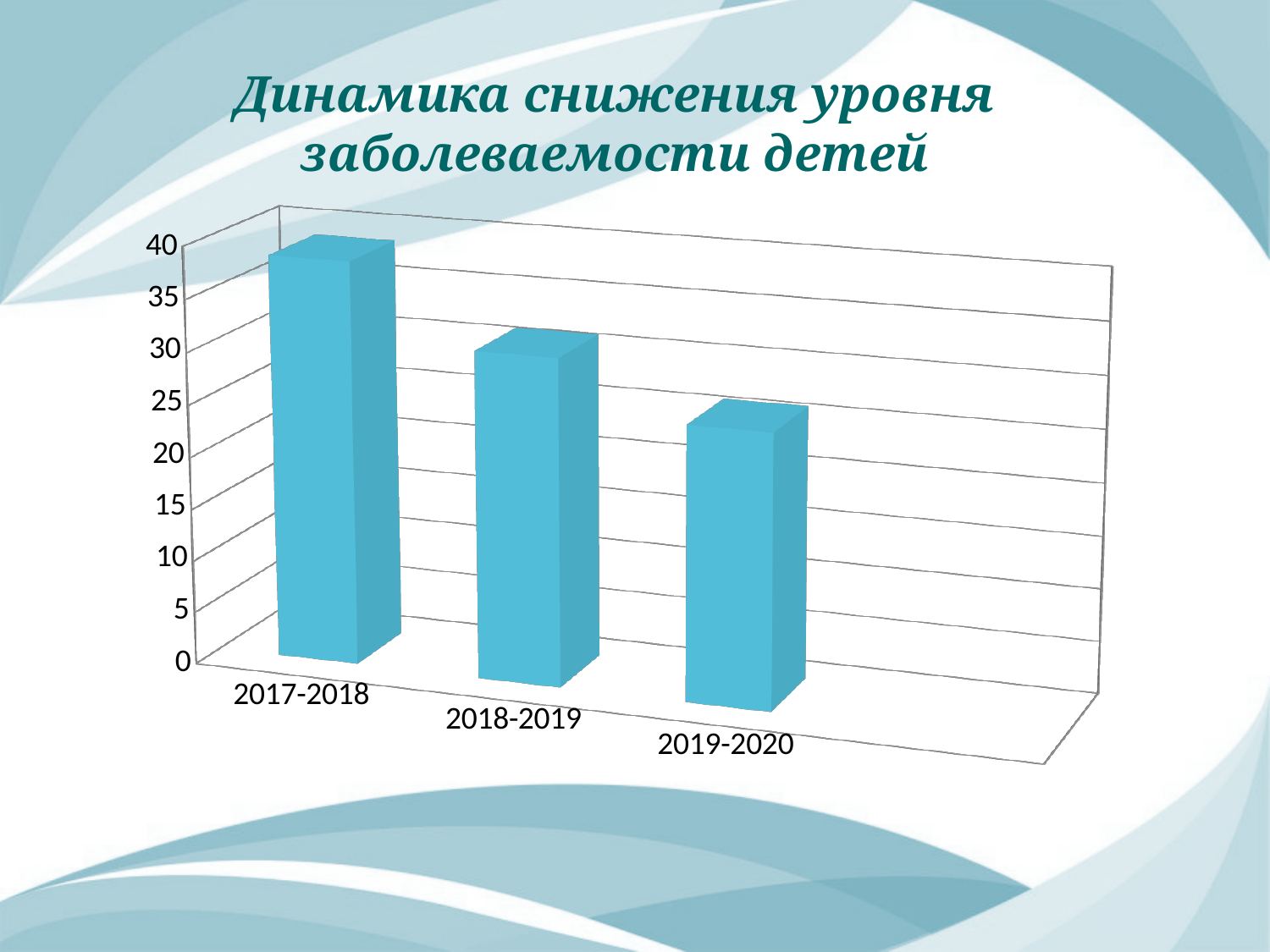
Is the value for 2018-2019 greater or less than 25? greater Which period has the highest bar in the chart? 2017-2018 What is the title of the chart on the slide? Динамика снижения уровня заболеваемости детей Do the values rise or fall from 2017-2018 to 2019-2020? fall Which period has the lowest bar in the chart? 2019-2020 Is the value for 2019-2020 greater or less than 30? less Is the value for 2018-2019 greater or less than 35? less What kind of chart is shown on the slide? bar chart How many categories (periods) are shown on the x axis of the chart? 3 Which is larger, the value for 2018-2019 or the value for 2019-2020? 2018-2019 Which is larger, the value for 2017-2018 or the value for 2018-2019? 2017-2018